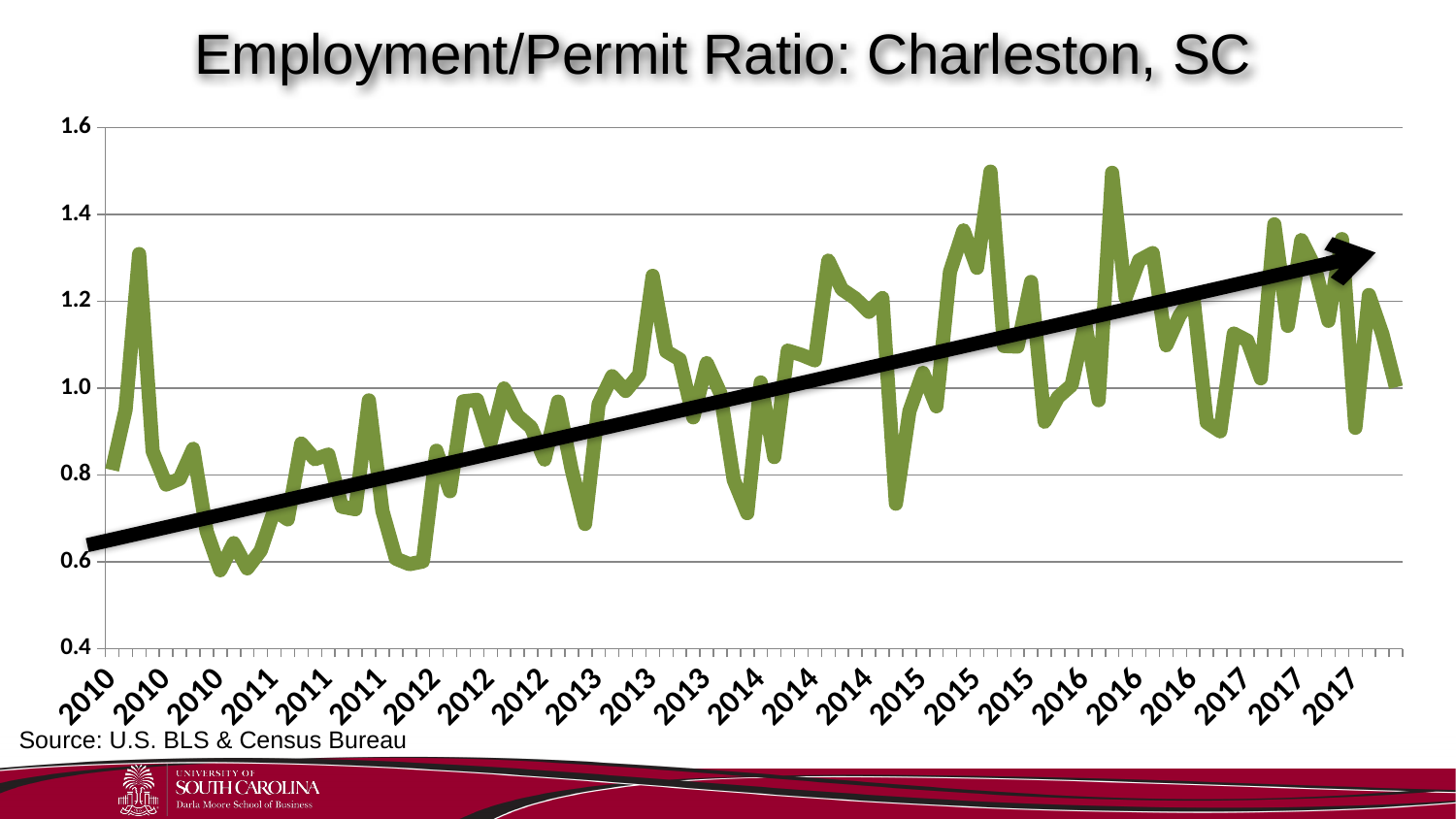
Is the highest value plotted on the chart greater or less than 1.4? greater How many year labels appear along the horizontal axis? 24 Overall, do the values rise or fall from 2010 to 2017? rise Is the first plotted value (at the start of 2010) greater or less than 1.0? less Is the lowest value plotted on the chart greater or less than 0.8? less What kind of chart is shown on the slide? line chart What is the highest value shown on the vertical axis? 1.6 What is the title of the chart? Employment/Permit Ratio: Charleston, SC What is the first year labelled on the horizontal axis? 2010 What is the last year labelled on the horizontal axis? 2017